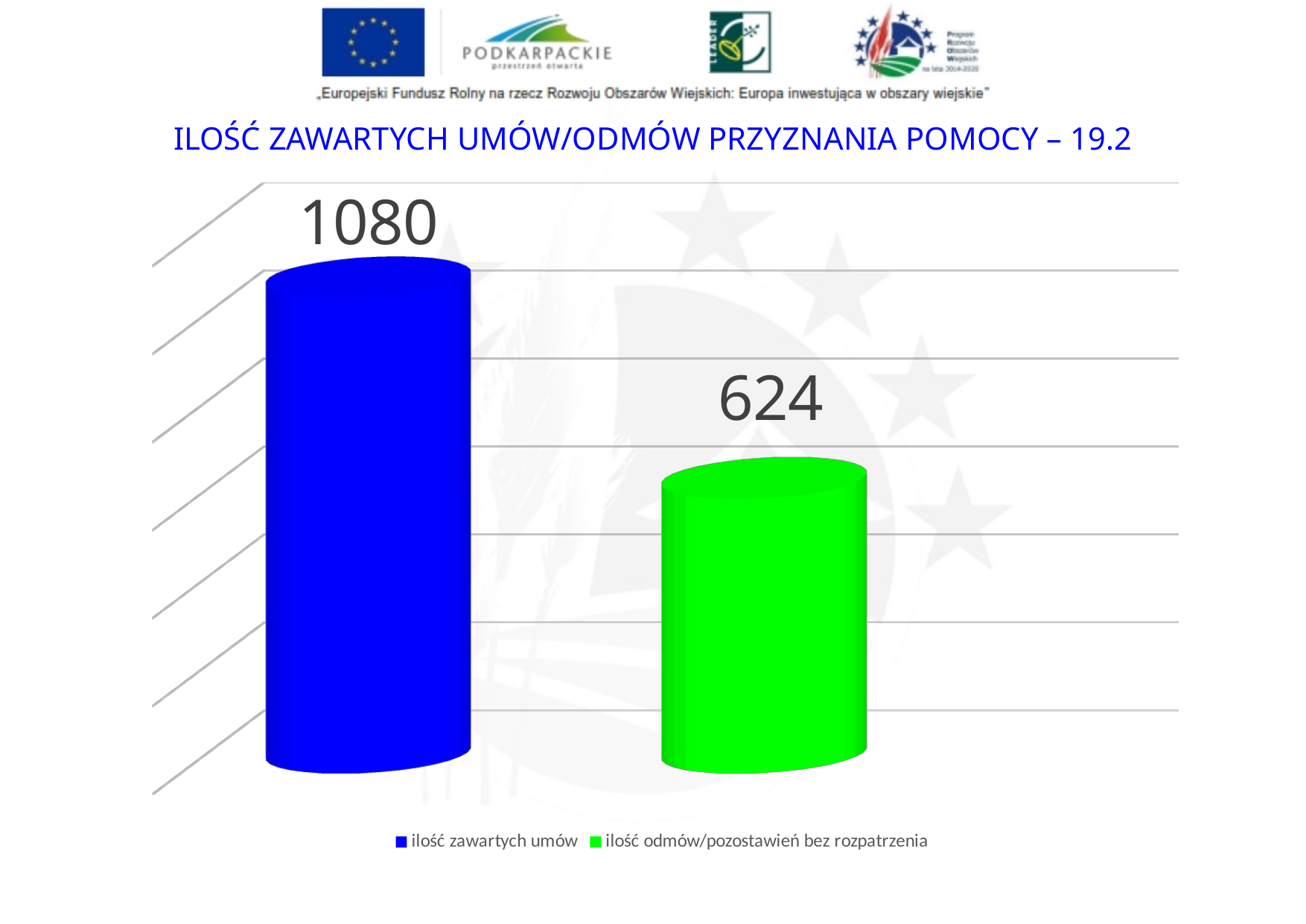
What is the difference between the value for "ilość zawartych umów" and the value for "ilość odmów/pozostawień bez rozpatrzenia"? 456 How many series does the legend list? 2 How many bars are plotted on the chart? 2 What is the value for "ilość zawartych umów"? 1080 Which series has the higher value? ilość zawartych umów What colour is the bar for "ilość odmów/pozostawień bez rozpatrzenia"? green Which series has the lower value? ilość odmów/pozostawień bez rozpatrzenia What kind of chart is shown on the slide? bar chart Is the value for "ilość zawartych umów" larger or smaller than the value for "ilość odmów/pozostawień bez rozpatrzenia"? larger What is the title of the chart? ILOŚĆ ZAWARTYCH UMÓW/ODMÓW PRZYZNANIA POMOCY – 19.2 What is the value for "ilość odmów/pozostawień bez rozpatrzenia"? 624